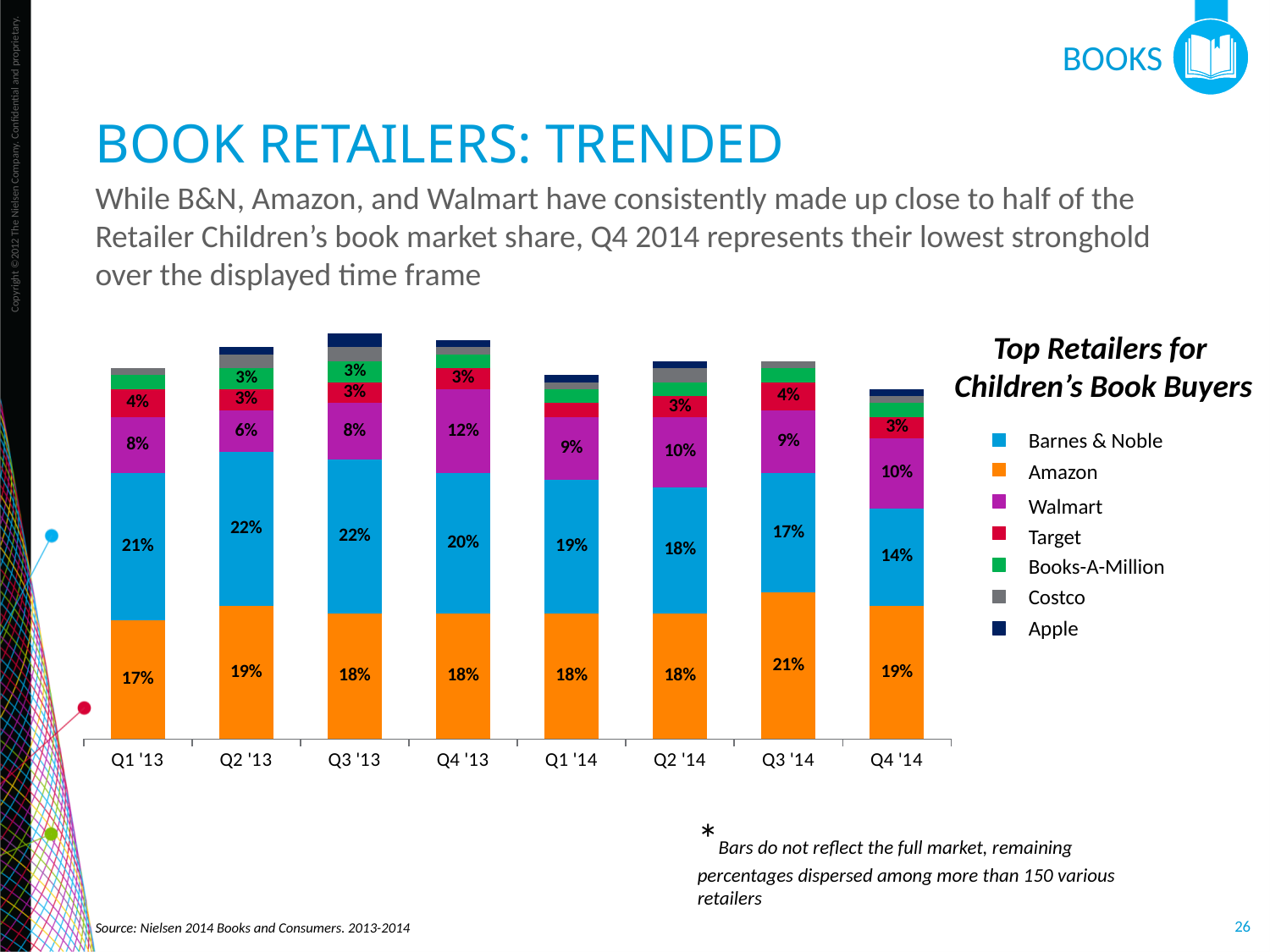
What is the Walmart share in Q4 '13? 12% In which quarter is the Amazon share highest? Q3 '14 What is the Amazon share in Q3 '14? 21% Does the Barnes & Noble share rise or fall from Q3 '13 to Q4 '14? Fall How many retailers does the chart's legend list? 7 What is the Barnes & Noble share in Q1 '13? 21% How many quarters are shown along the x axis of the chart? 8 What is the Target share in Q1 '13? 4% What kind of chart is shown on the slide? Stacked bar chart In Q3 '14, which has the larger share, Amazon or Barnes & Noble? Amazon In Q4 '14, how many percentage points higher is Amazon's share than Barnes & Noble's? 5 percentage points In which quarter is the Barnes & Noble share lowest? Q4 '14